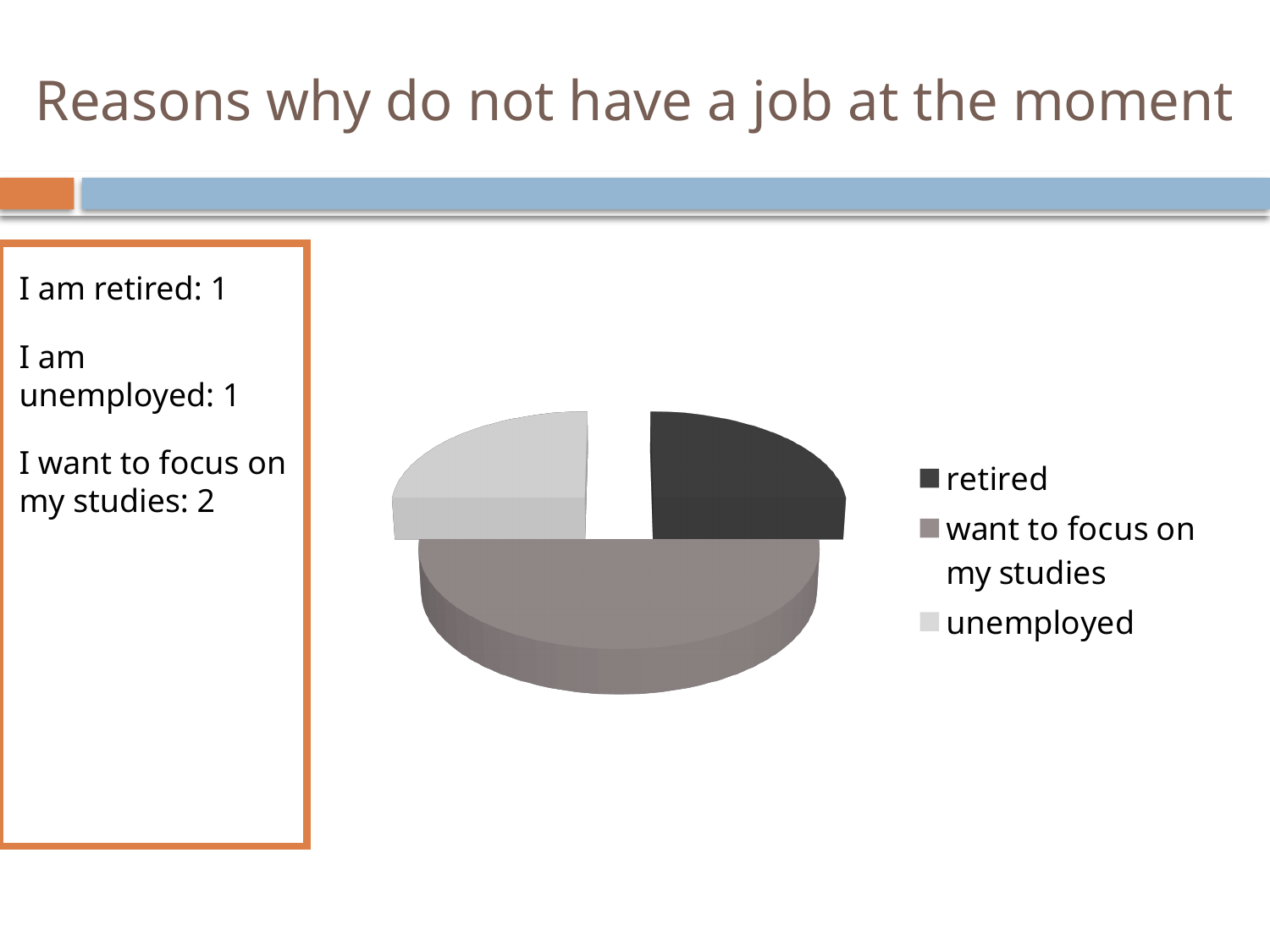
How many respondents said they are retired? 1 Which legend entry is shown in the darkest colour in the pie chart? retired How many respondents said they want to focus on their studies? 2 What kind of chart is shown on the slide? pie chart Which reason has the largest slice in the pie chart? want to focus on my studies What is the difference between the count for 'want to focus on my studies' and the count for 'unemployed'? 1 How many entries does the legend of the pie chart list? 3 What share of the pie does 'want to focus on my studies' represent? 50% What share of the pie does 'retired' represent? 25% Which is larger: the slice for 'want to focus on my studies' or the slice for 'retired'? want to focus on my studies How many respondents said they are unemployed? 1 How many slices does the pie chart have? 3